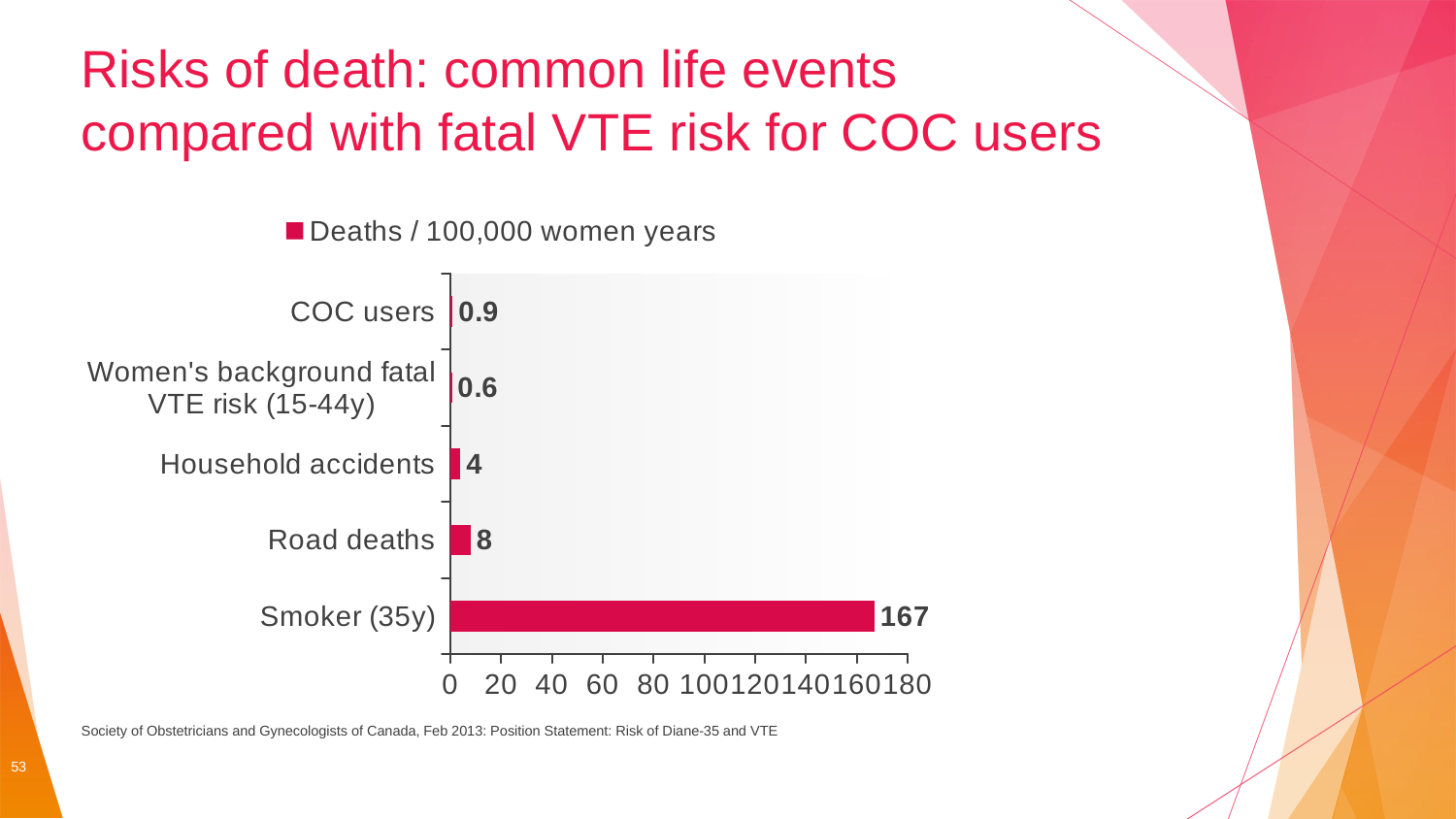
What is the value for Women's background fatal VTE risk (15-44y)? 0.6 How many categories are shown in the chart? 5 Is the value for Smoker (35y) greater or less than 160? greater Which is larger, the value for COC users or the value for Household accidents? Household accidents Which category has the lowest value? Women's background fatal VTE risk (15-44y) What is the difference between the values for Road deaths and Household accidents? 4 What series name does the legend show? Deaths / 100,000 women years What kind of chart is shown on the slide? bar chart What is the value for COC users? 0.9 What is the value for Road deaths? 8 What is the value for Smoker (35y)? 167 Which category has the highest value? Smoker (35y)